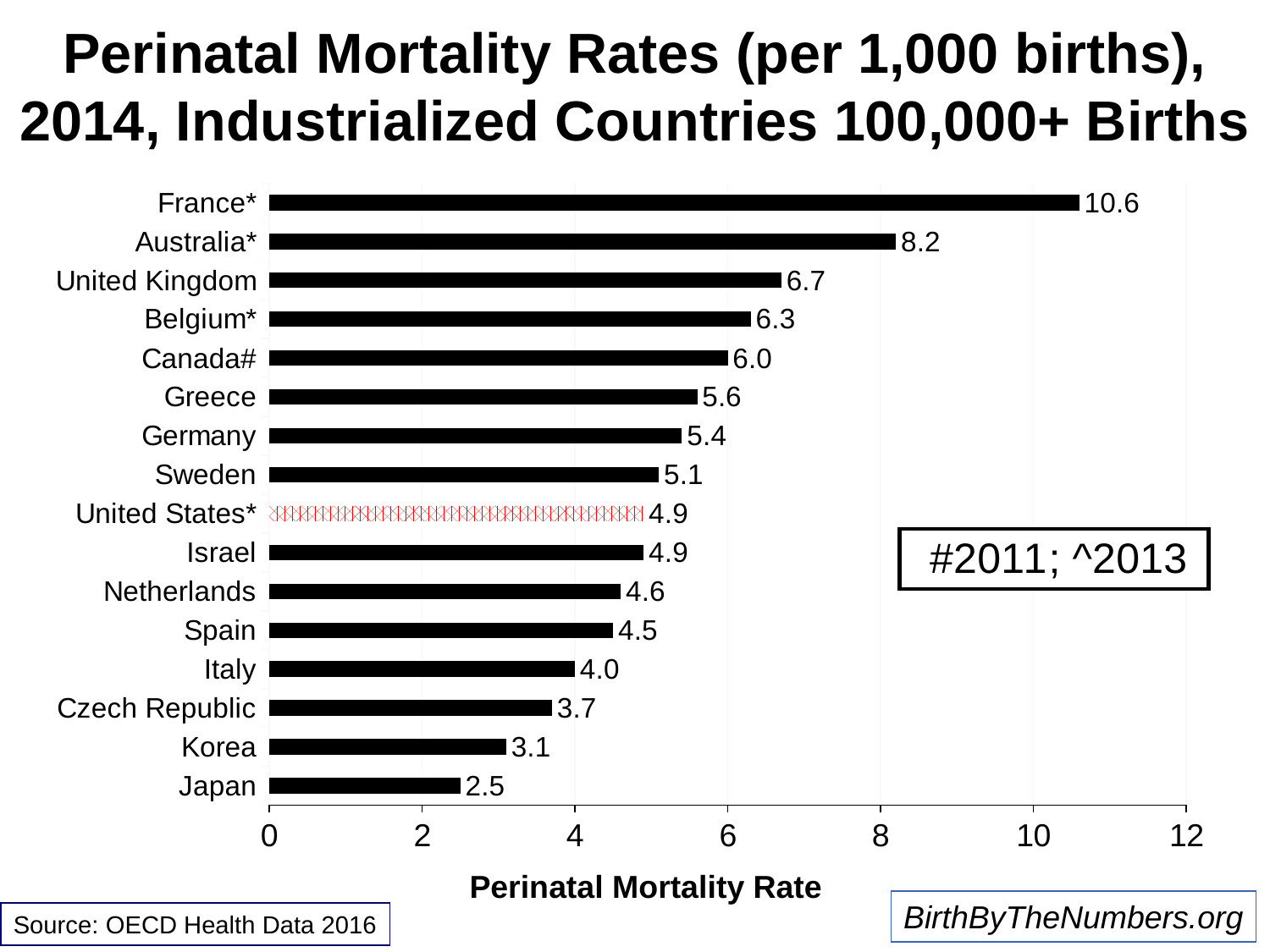
What is the difference between the perinatal mortality rates of France* and Australia*? 2.4 What is the perinatal mortality rate for France*? 10.6 What kind of chart is shown on the slide? Bar chart Which country has the lowest perinatal mortality rate? Japan How many countries are shown in the chart? 16 What is the label of the x axis? Perinatal Mortality Rate Which country has the highest perinatal mortality rate? France* Which has a higher perinatal mortality rate, Germany or Sweden? Germany Is the value for Canada# greater or less than 4? greater What is the difference between the perinatal mortality rates of the United Kingdom and Japan? 4.2 What is the perinatal mortality rate for Japan? 2.5 What is the perinatal mortality rate for the United States*? 4.9